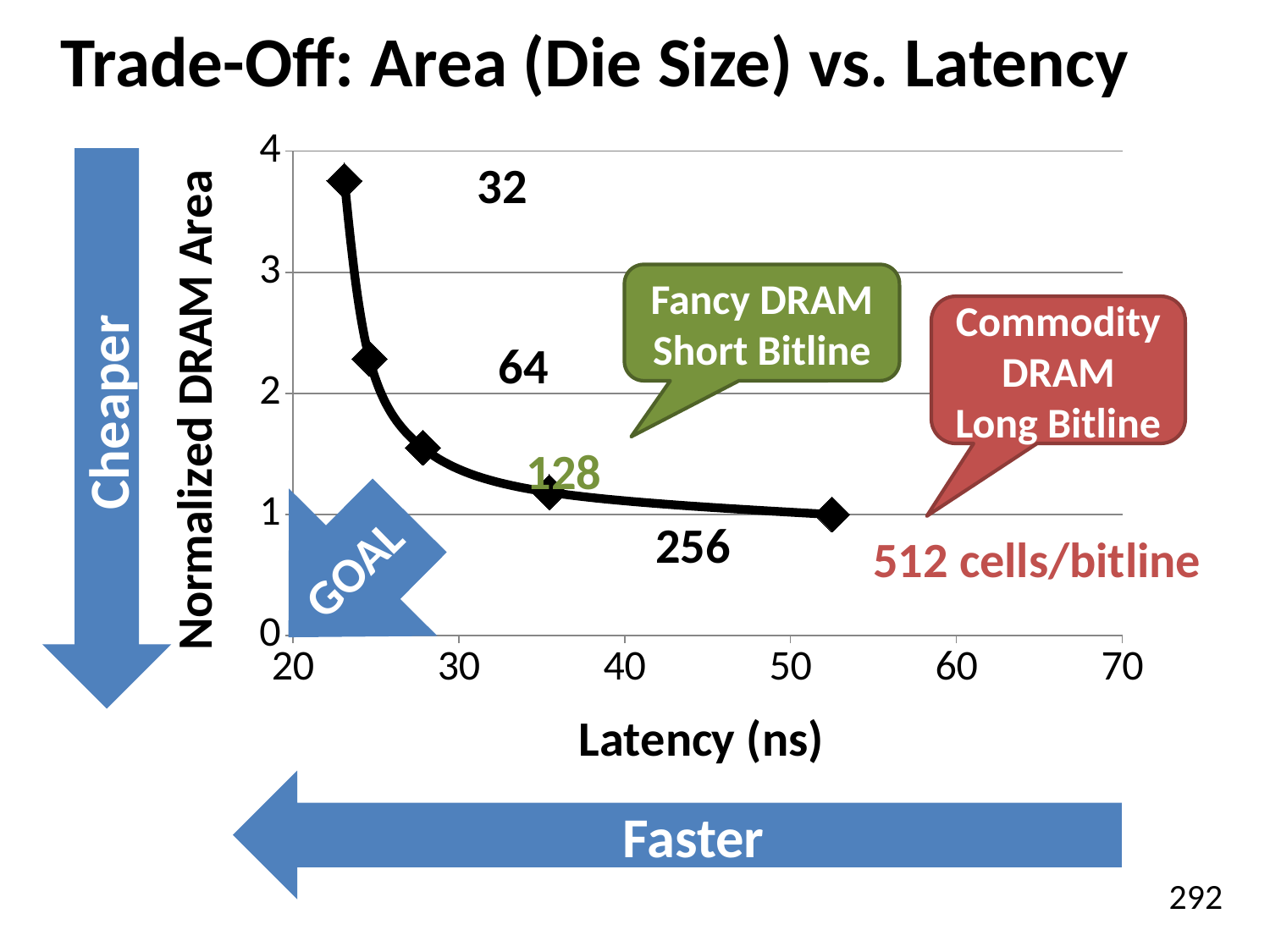
What is the label of the y axis? Normalized DRAM Area Is the normalized DRAM area for the 64 cells/bitline point greater or less than 2? greater What is the normalized DRAM area for 512 cells/bitline? 1 Which cells/bitline configuration has the highest normalized DRAM area? 32 Which cells/bitline configuration has the lowest normalized DRAM area? 512 cells/bitline Which has a larger normalized DRAM area, the 32 or the 128 cells/bitline point? 32 What kind of chart is shown on the slide? line chart Is the normalized DRAM area for the 32 cells/bitline point greater or less than 3? greater Is the latency for the 512 cells/bitline point greater or less than 50 ns? greater How many data points are plotted on the chart? 5 What is the label of the x axis? Latency (ns) As latency increases along the x axis, does the normalized DRAM area rise or fall? fall